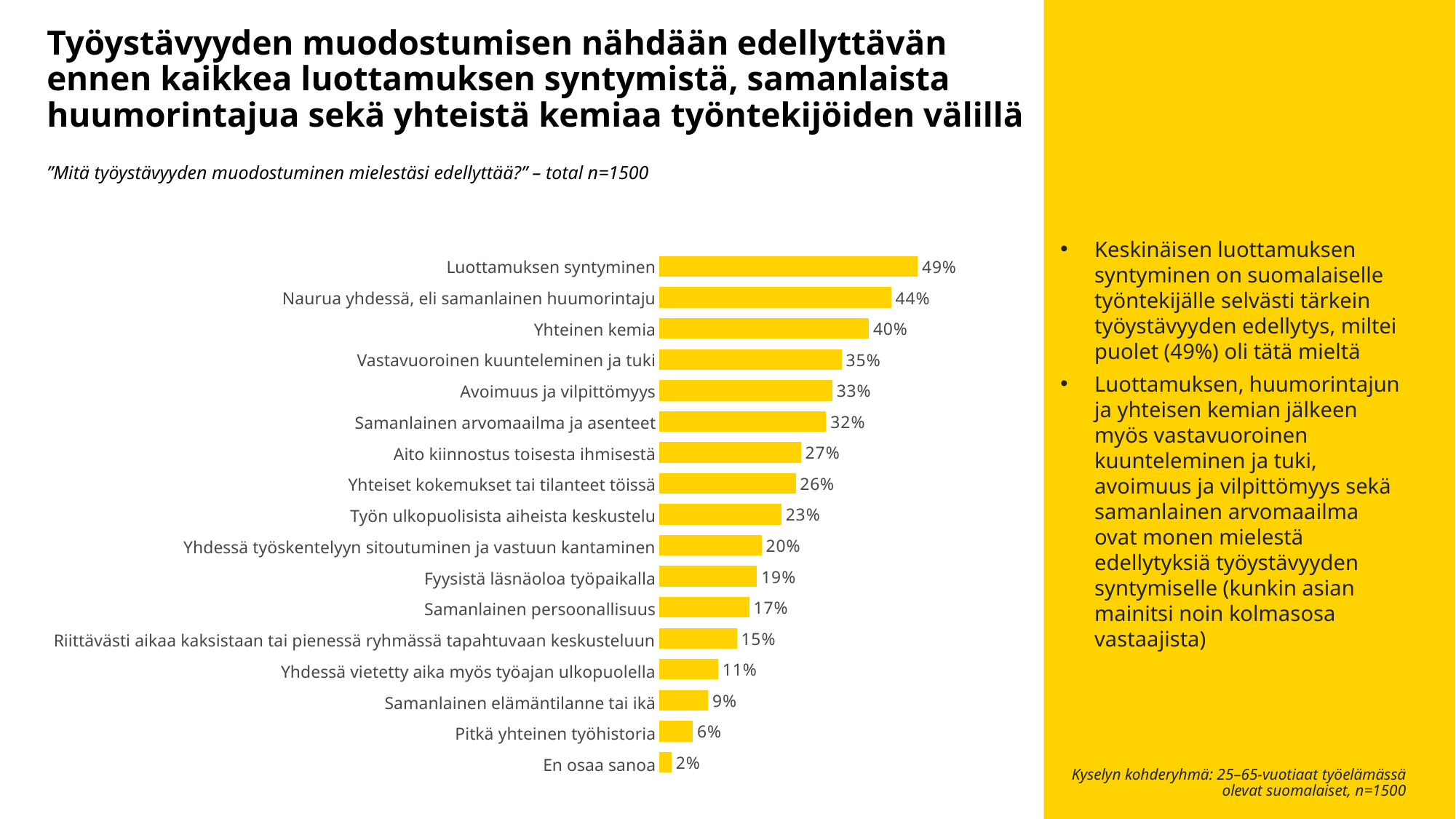
How many categories are shown in the bar chart? 17 What percentage is shown for "Fyysistä läsnäoloa työpaikalla"? 19% What colour are the bars in the chart? Yellow Which is larger: "Aito kiinnostus toisesta ihmisestä" or "Työn ulkopuolisista aiheista keskustelu"? Aito kiinnostus toisesta ihmisestä What is the difference between "Luottamuksen syntyminen" and "Naurua yhdessä, eli samanlainen huumorintaju"? 5 percentage points Which category has the lowest value in the chart? En osaa sanoa What is the value shown for "Yhteinen kemia"? 40% What is the difference between "Vastavuoroinen kuunteleminen ja tuki" and "Pitkä yhteinen työhistoria"? 29 percentage points What is the value for "Samanlainen elämäntilanne tai ikä"? 9% Which category has the highest value in the chart? Luottamuksen syntyminen What percentage of respondents chose "Luottamuksen syntyminen"? 49% What type of chart is shown on the slide? Bar chart